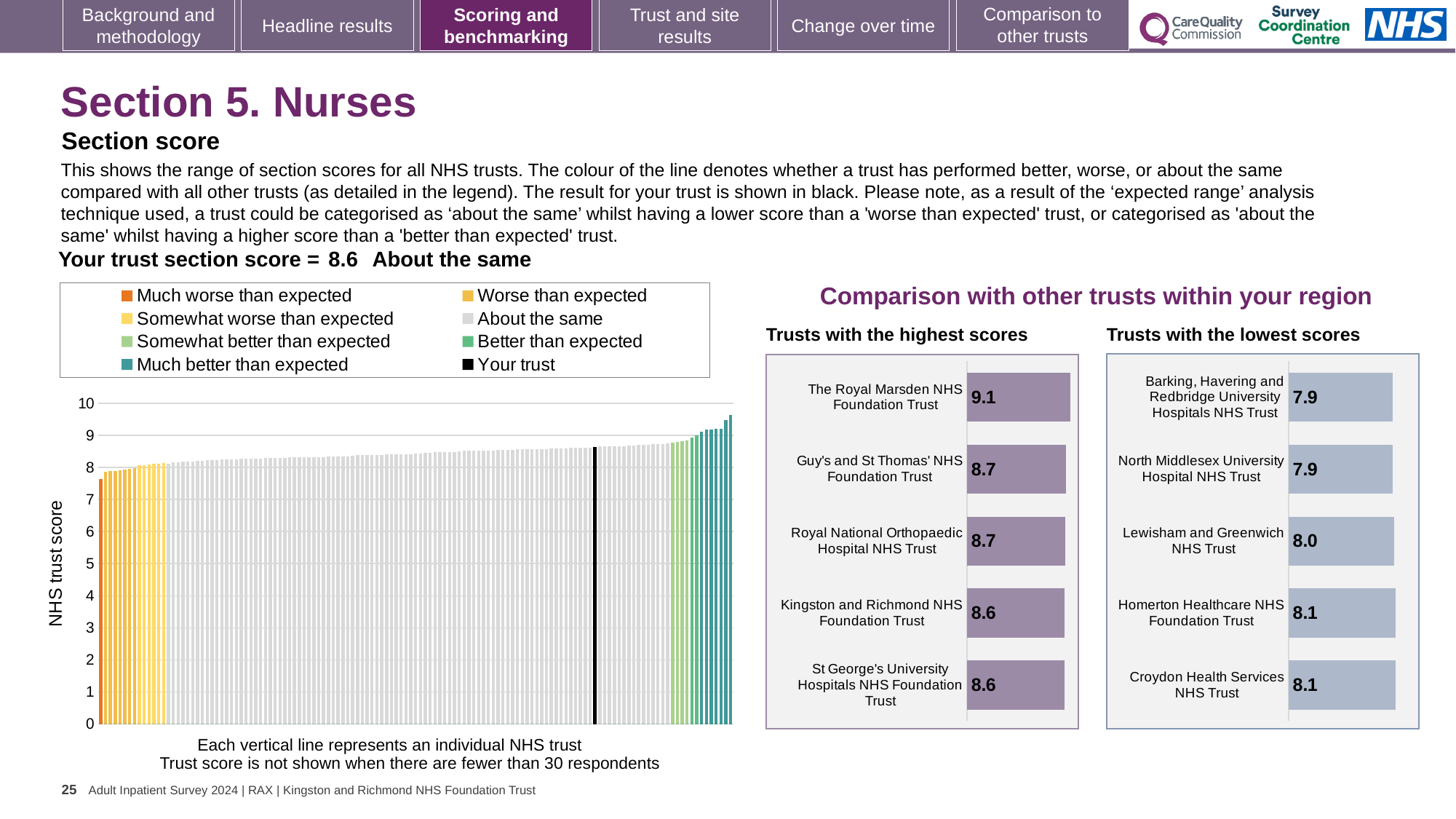
In the 'Trusts with the highest scores' chart, how many trusts are listed? 5 In the 'Trusts with the lowest scores' chart, what is the lowest score shown? 7.9 In the 'Trusts with the lowest scores' chart, which has the higher score: Croydon Health Services NHS Trust or North Middlesex University Hospital NHS Trust? Croydon Health Services NHS Trust In the large chart on the left, do the trust scores rise or fall from left to right along the x axis? rise What kind of chart is the large chart on the left showing NHS trust scores? bar chart In the large chart on the left, is the value for the black 'Your trust' bar greater or less than 8? greater In the 'Trusts with the highest scores' chart, which trust has the highest score? The Royal Marsden NHS Foundation Trust How many entries does the legend of the large chart on the left list? 8 In the 'Trusts with the lowest scores' chart, what is the score for Lewisham and Greenwich NHS Trust? 8.0 What is the section score for your trust, as stated on the slide? 8.6 In the 'Trusts with the highest scores' chart, what is the difference between the scores of The Royal Marsden NHS Foundation Trust and Kingston and Richmond NHS Foundation Trust? 0.5 In the 'Trusts with the highest scores' chart, what is the score for The Royal Marsden NHS Foundation Trust? 9.1